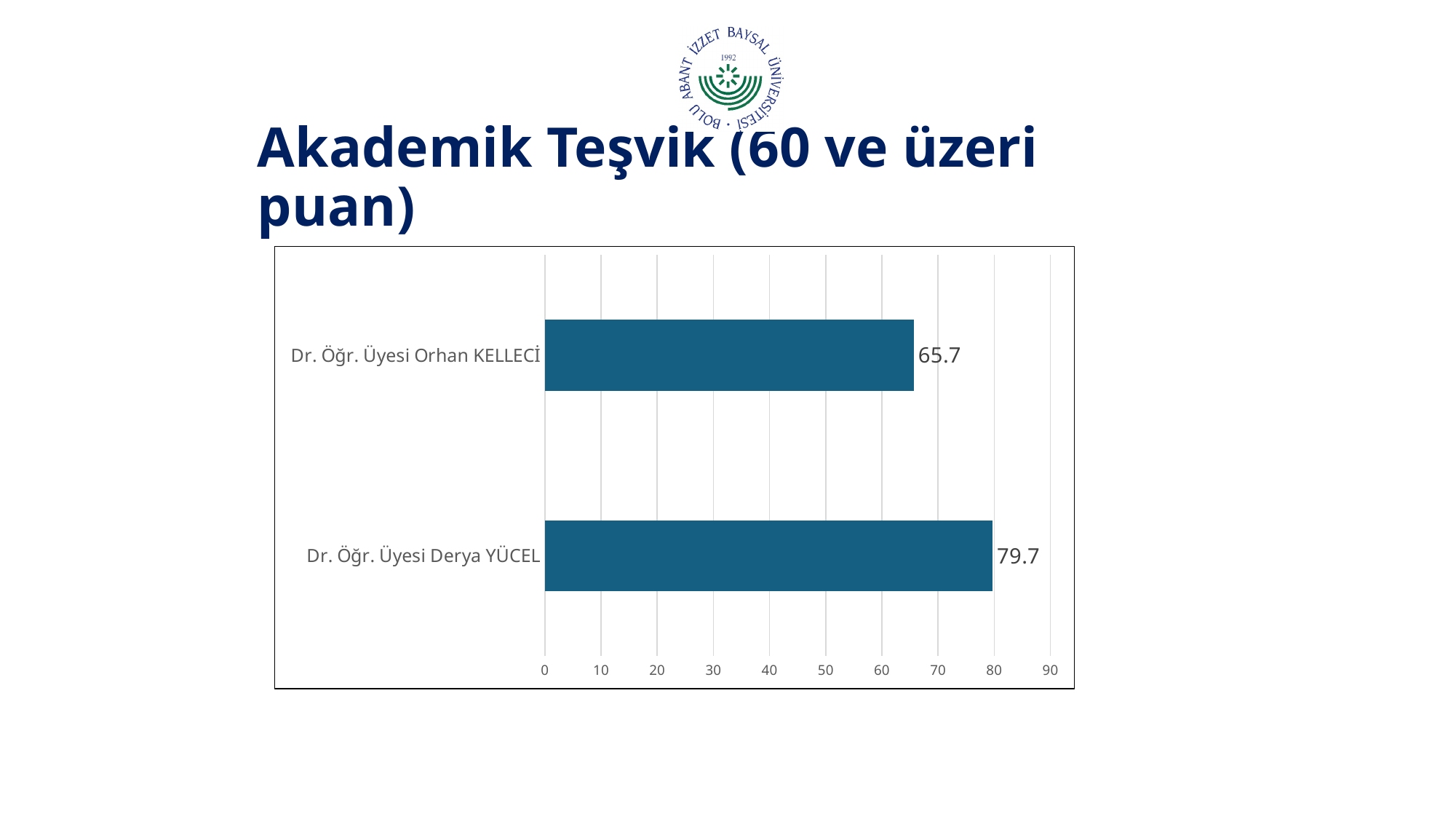
Is the value for Dr. Öğr. Üyesi Orhan KELLECİ greater or less than 70? less Which category has the lowest value? Dr. Öğr. Üyesi Orhan KELLECİ How many categories are shown in the chart? 2 What is the difference between the values for Dr. Öğr. Üyesi Derya YÜCEL and Dr. Öğr. Üyesi Orhan KELLECİ? 14 What is the value for Dr. Öğr. Üyesi Derya YÜCEL? 79.7 What kind of chart is shown on the slide? bar chart Which is larger, the value for Dr. Öğr. Üyesi Orhan KELLECİ or the value for Dr. Öğr. Üyesi Derya YÜCEL? Dr. Öğr. Üyesi Derya YÜCEL Which category has the highest value? Dr. Öğr. Üyesi Derya YÜCEL What is the value for Dr. Öğr. Üyesi Orhan KELLECİ? 65.7 Is the value for Dr. Öğr. Üyesi Derya YÜCEL greater or less than 70? greater What is the highest tick value shown on the horizontal axis? 90 What is the title of the slide? Akademik Teşvik (60 ve üzeri puan)